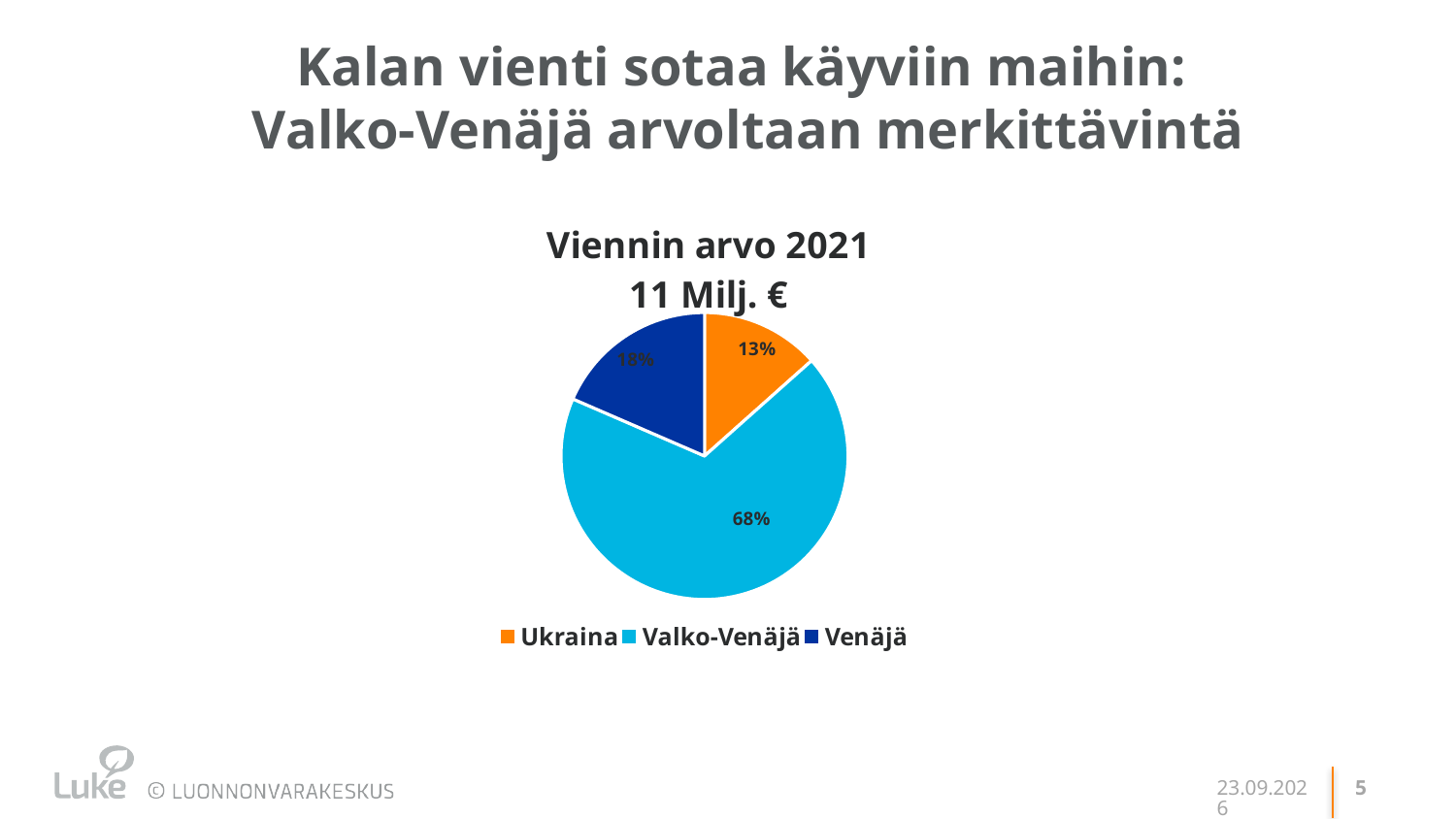
What share of the pie does Venäjä account for? 18% Which country has the smallest slice of the pie? Ukraina What is the title of the chart? Viennin arvo 2021 11 Milj. € How many entries does the legend list? 3 How many slices does the pie chart have? 3 Which slice is larger, Venäjä or Ukraina? Venäjä What share of the pie does Ukraina account for? 13% What share of the pie does Valko-Venäjä account for? 68% What is the difference in percentage points between the Valko-Venäjä and Venäjä slices? 50 Which country has the largest slice of the pie? Valko-Venäjä What is the difference in percentage points between the Venäjä and Ukraina slices? 5 What type of chart is shown on the slide? Pie chart